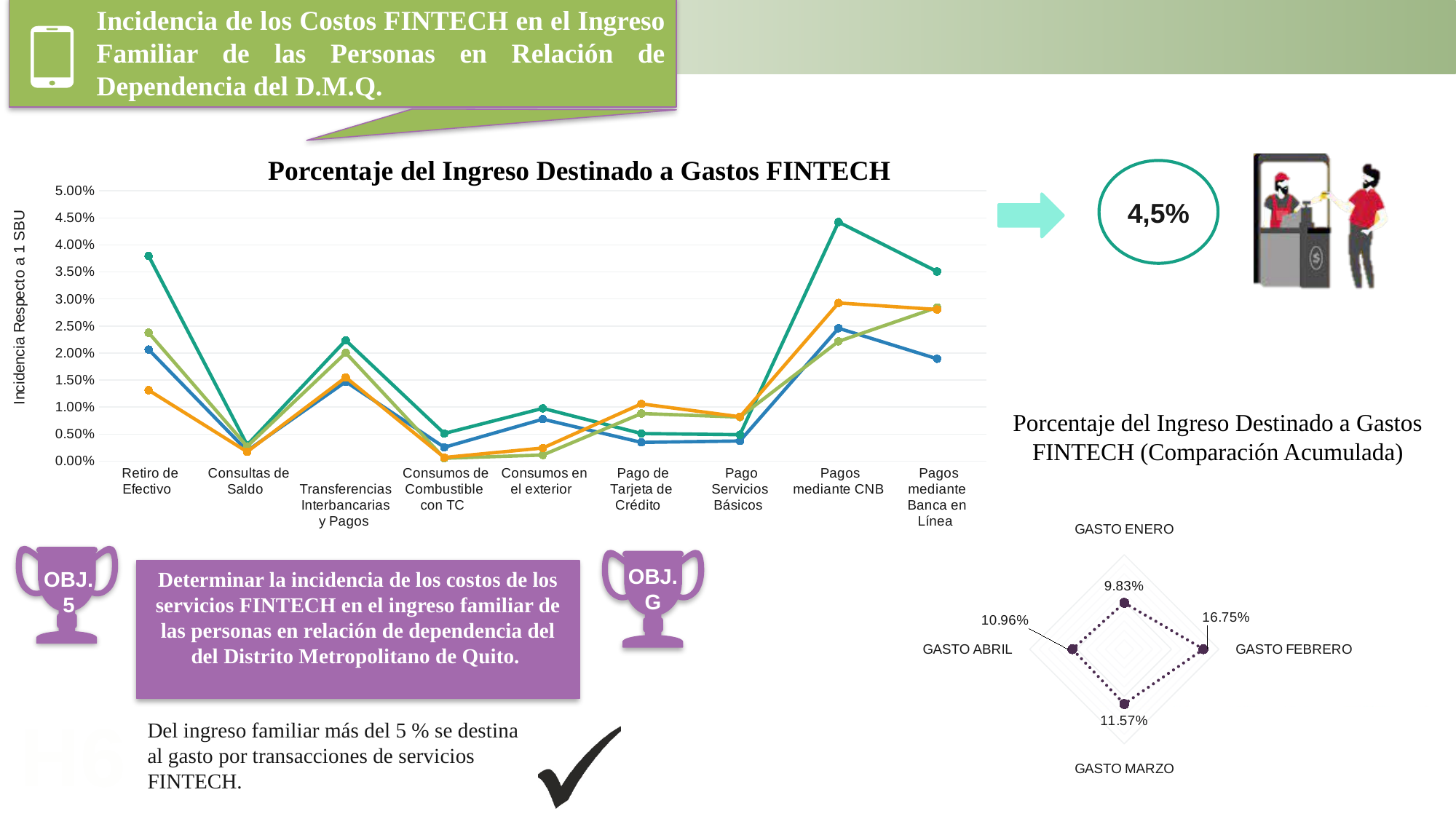
In the radar chart 'Porcentaje del Ingreso Destinado a Gastos FINTECH (Comparación Acumulada)', what is the value for GASTO FEBRERO? 16.75% In the line chart 'Porcentaje del Ingreso Destinado a Gastos FINTECH', which category has the highest value of any line? Pagos mediante CNB In the radar chart 'Porcentaje del Ingreso Destinado a Gastos FINTECH (Comparación Acumulada)', which month has the lowest value? GASTO ENERO How many categories are shown on the x axis of the line chart 'Porcentaje del Ingreso Destinado a Gastos FINTECH'? 9 In the radar chart 'Porcentaje del Ingreso Destinado a Gastos FINTECH (Comparación Acumulada)', what is the difference between GASTO FEBRERO and GASTO ENERO? 6.92% In the radar chart 'Porcentaje del Ingreso Destinado a Gastos FINTECH (Comparación Acumulada)', which is larger, GASTO MARZO or GASTO ABRIL? GASTO MARZO In the radar chart 'Porcentaje del Ingreso Destinado a Gastos FINTECH (Comparación Acumulada)', what is the value for GASTO ABRIL? 10.96% What kind of chart is 'Porcentaje del Ingreso Destinado a Gastos FINTECH' on the left of the slide? Line chart How many categories does the radar chart 'Porcentaje del Ingreso Destinado a Gastos FINTECH (Comparación Acumulada)' show? 4 In the radar chart 'Porcentaje del Ingreso Destinado a Gastos FINTECH (Comparación Acumulada)', what is the value for GASTO MARZO? 11.57% In the radar chart 'Porcentaje del Ingreso Destinado a Gastos FINTECH (Comparación Acumulada)', which month has the highest value? GASTO FEBRERO In the radar chart 'Porcentaje del Ingreso Destinado a Gastos FINTECH (Comparación Acumulada)', what is the value for GASTO ENERO? 9.83%